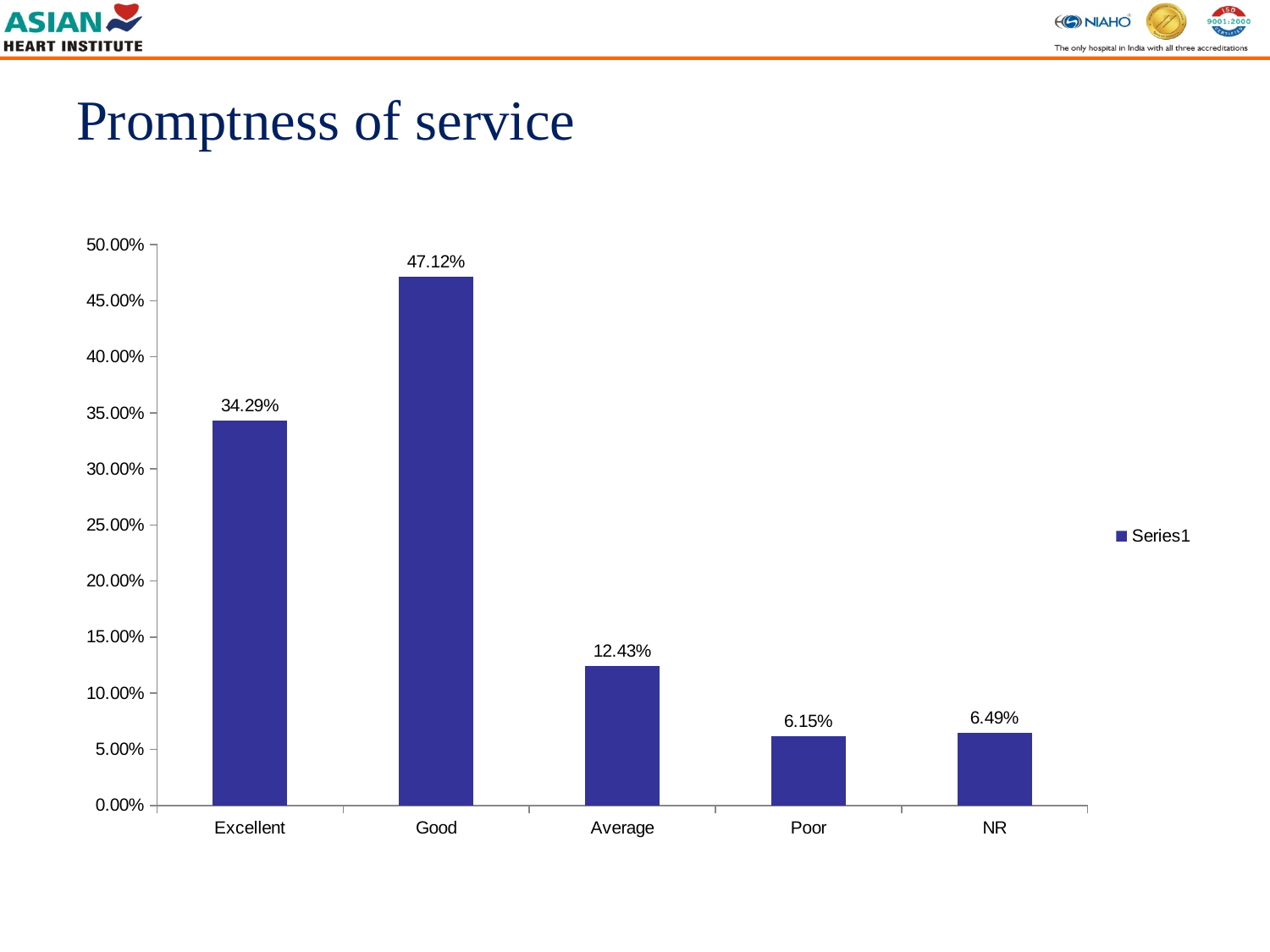
What is the value for Good? 47.12% What is the title of the slide? Promptness of service Which category has the highest value? Good Which category has the lowest value? Poor Which is larger, the value for Excellent or the value for Average? Excellent What is the value for Average? 12.43% How many categories are shown on the x axis? 5 What is the value for NR? 6.49% What is the value for Excellent? 34.29% Is the value for Average greater or less than 15.00%? less What is the difference between the values for Good and Excellent? 12.83% What kind of chart is shown on the slide? bar chart